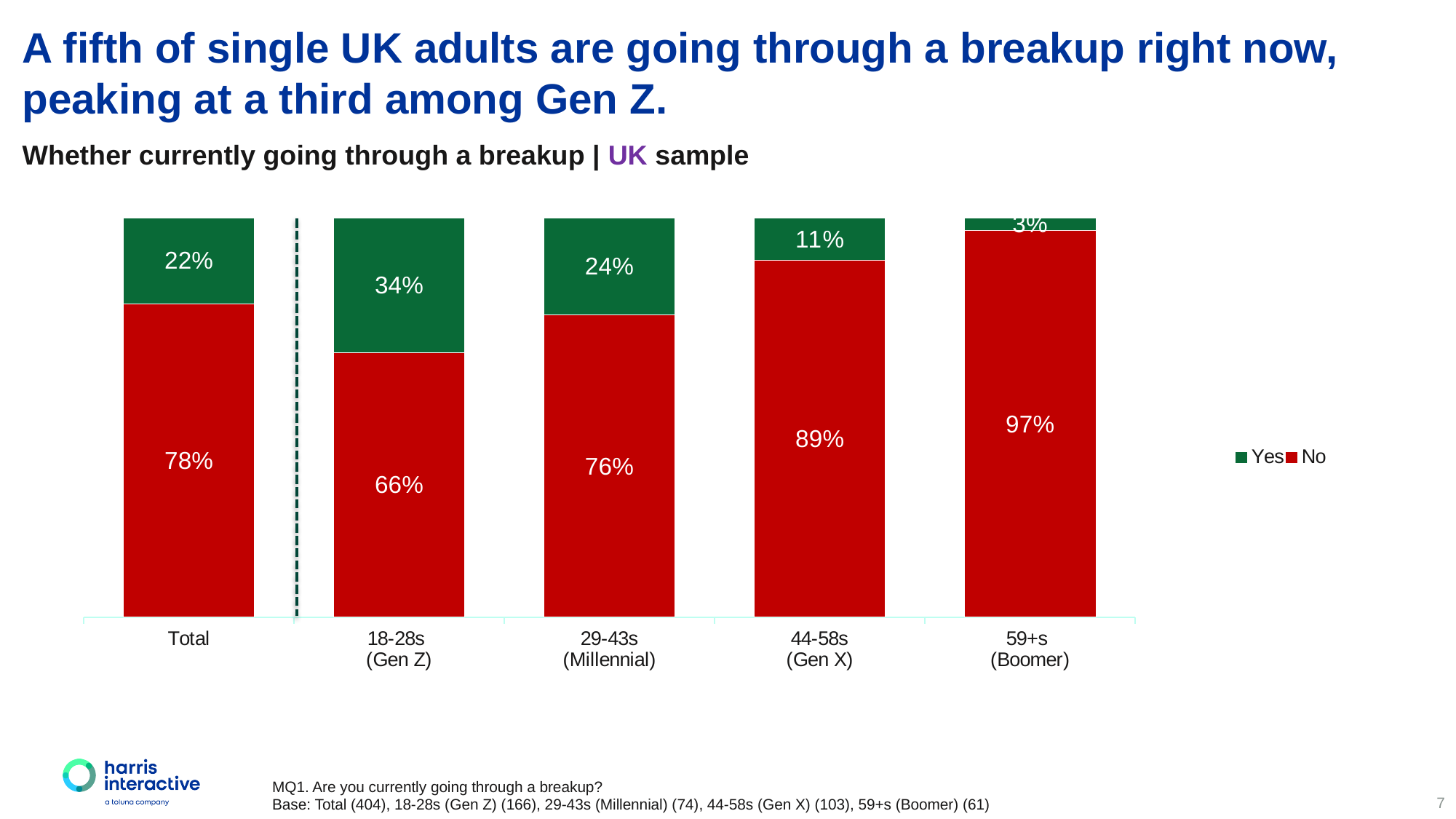
Which age group has the highest Yes percentage? 18-28s (Gen Z) Which age group has the lowest Yes percentage? 59+s (Boomer) What is the difference between the Yes percentages for 18-28s (Gen Z) and 29-43s (Millennial)? 10 percentage points How many series does the legend list? 2 What percentage of the Total sample answered Yes to currently going through a breakup? 22% Which is larger: the No value for 29-43s (Millennial) or the No value for 44-58s (Gen X)? 44-58s (Gen X) What is the No value for the 18-28s (Gen Z) group? 66% What is the Yes value for the 44-58s (Gen X) group? 11% What kind of chart is shown on the slide? Stacked bar chart What is the No value for the 59+s (Boomer) group? 97% Moving from the 18-28s (Gen Z) group to the 59+s (Boomer) group, does the Yes percentage rise or fall? Fall How many bars are shown on the chart? 5